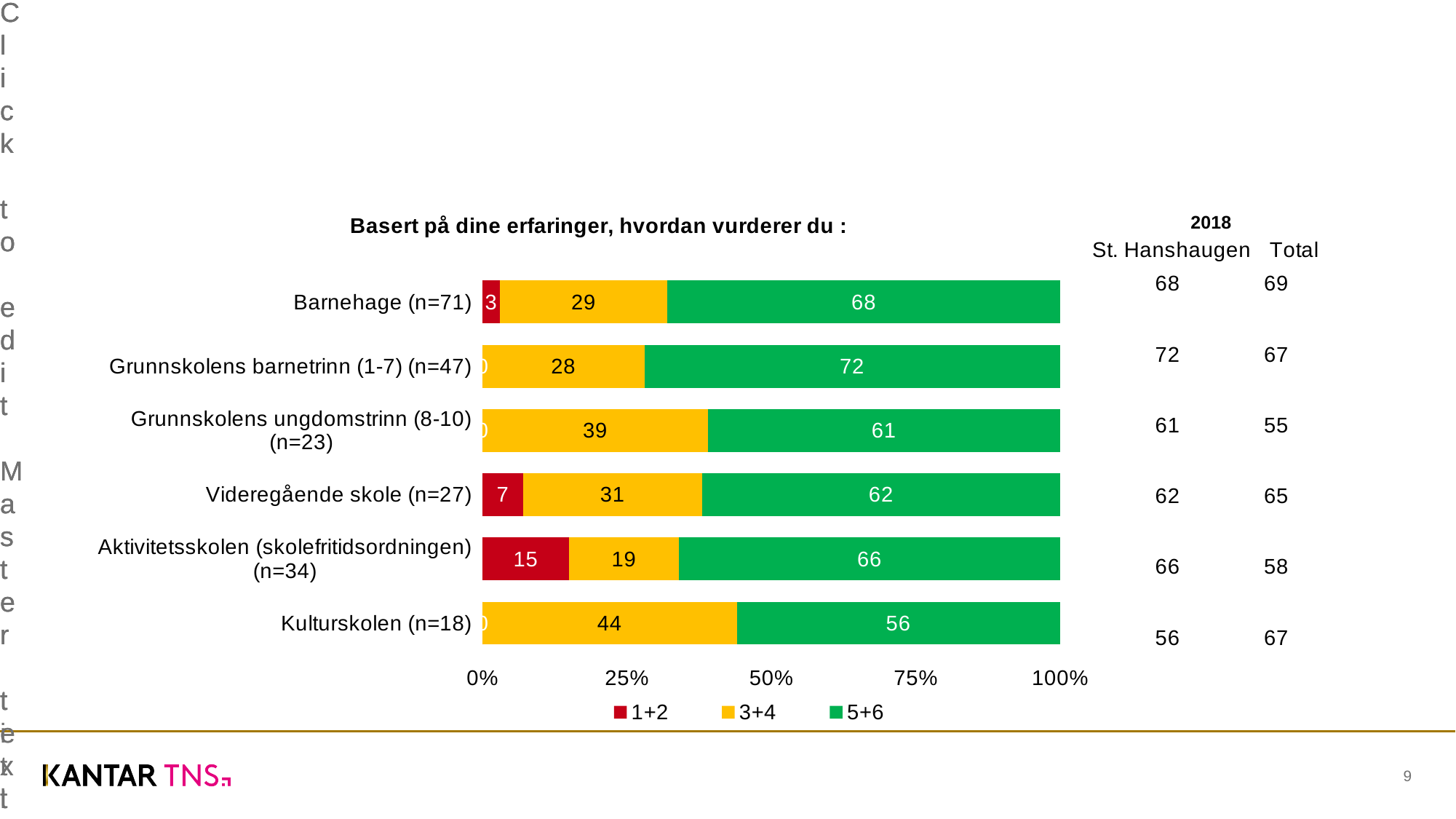
What kind of chart is shown on the slide? Stacked bar chart What is the 5+6 value for Barnehage (n=71)? 68 What is the title of the chart? Basert på dine erfaringer, hvordan vurderer du : Which is larger: the 5+6 value for Videregående skole (n=27) or for Aktivitetsskolen (skolefritidsordningen) (n=34)? Aktivitetsskolen (skolefritidsordningen) (n=34) What is the 1+2 value for Aktivitetsskolen (skolefritidsordningen) (n=34)? 15 Which category has the lowest 5+6 value? Kulturskolen (n=18) Which category has the highest 5+6 value? Grunnskolens barnetrinn (1-7) (n=47) What is the difference between the 3+4 values for Grunnskolens ungdomstrinn (8-10) (n=23) and Grunnskolens barnetrinn (1-7) (n=47)? 11 How many series does the legend list? 3 Which category has the highest 1+2 value? Aktivitetsskolen (skolefritidsordningen) (n=34) What is the 3+4 value for Kulturskolen (n=18)? 44 How many categories are plotted in the chart? 6